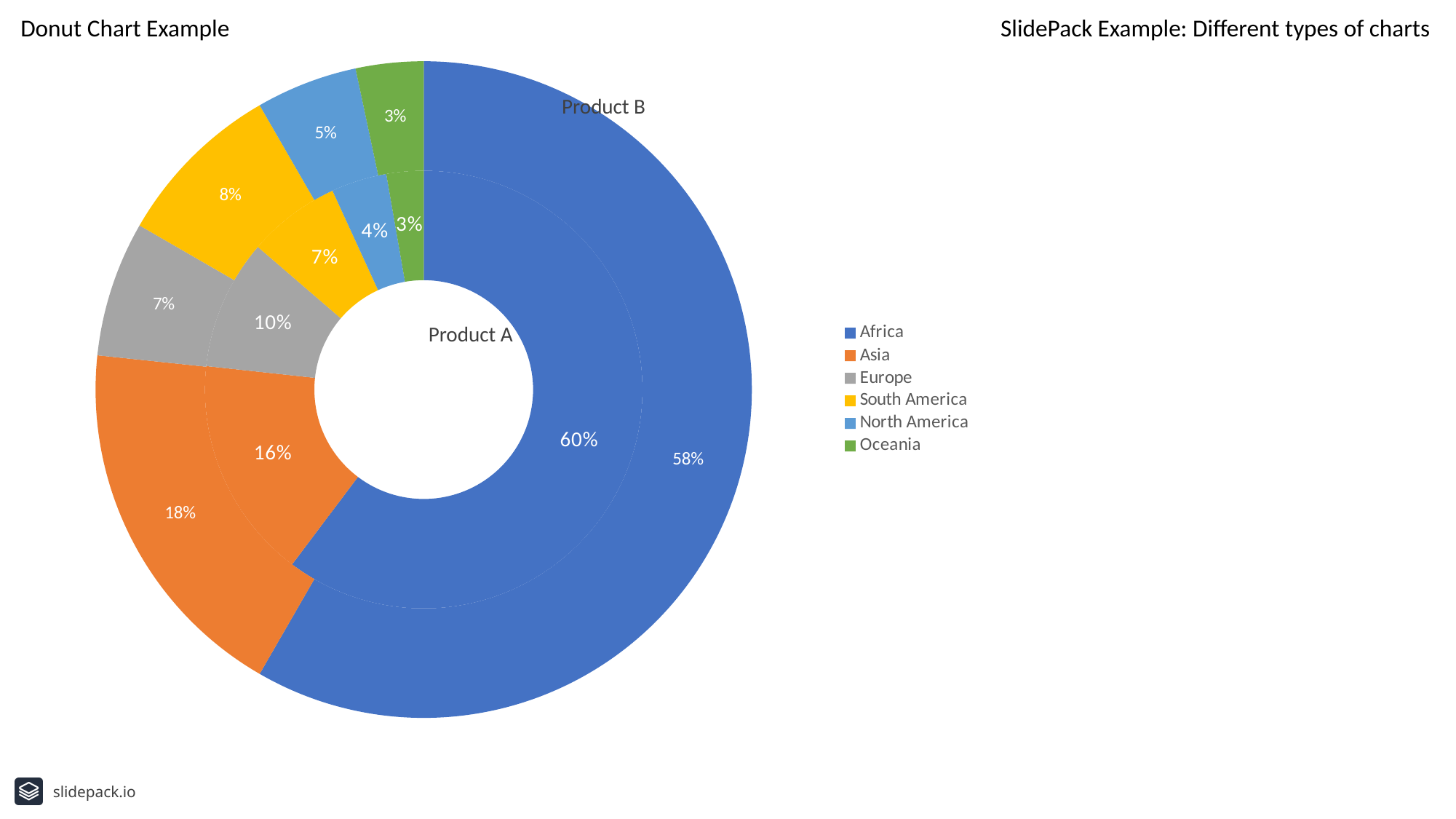
What kind of chart is shown on the slide? Donut chart Which region has the largest share in the Product A ring? Africa What is the share for North America in the Product B ring? 5% What is the share for Africa in the Product B ring? 58% Which is larger: the Europe share for Product A or the Europe share for Product B? Product A What is the share for Asia in the Product B ring? 18% How many rings (series) does the donut chart have? 2 What is the difference between the Asia shares for Product B and Product A? 2% Which region has the smallest share in the Product B ring? Oceania How many regions are listed in the legend? 6 What is the share for Europe in the Product A ring? 10% What is the share for Africa in the Product A ring? 60%